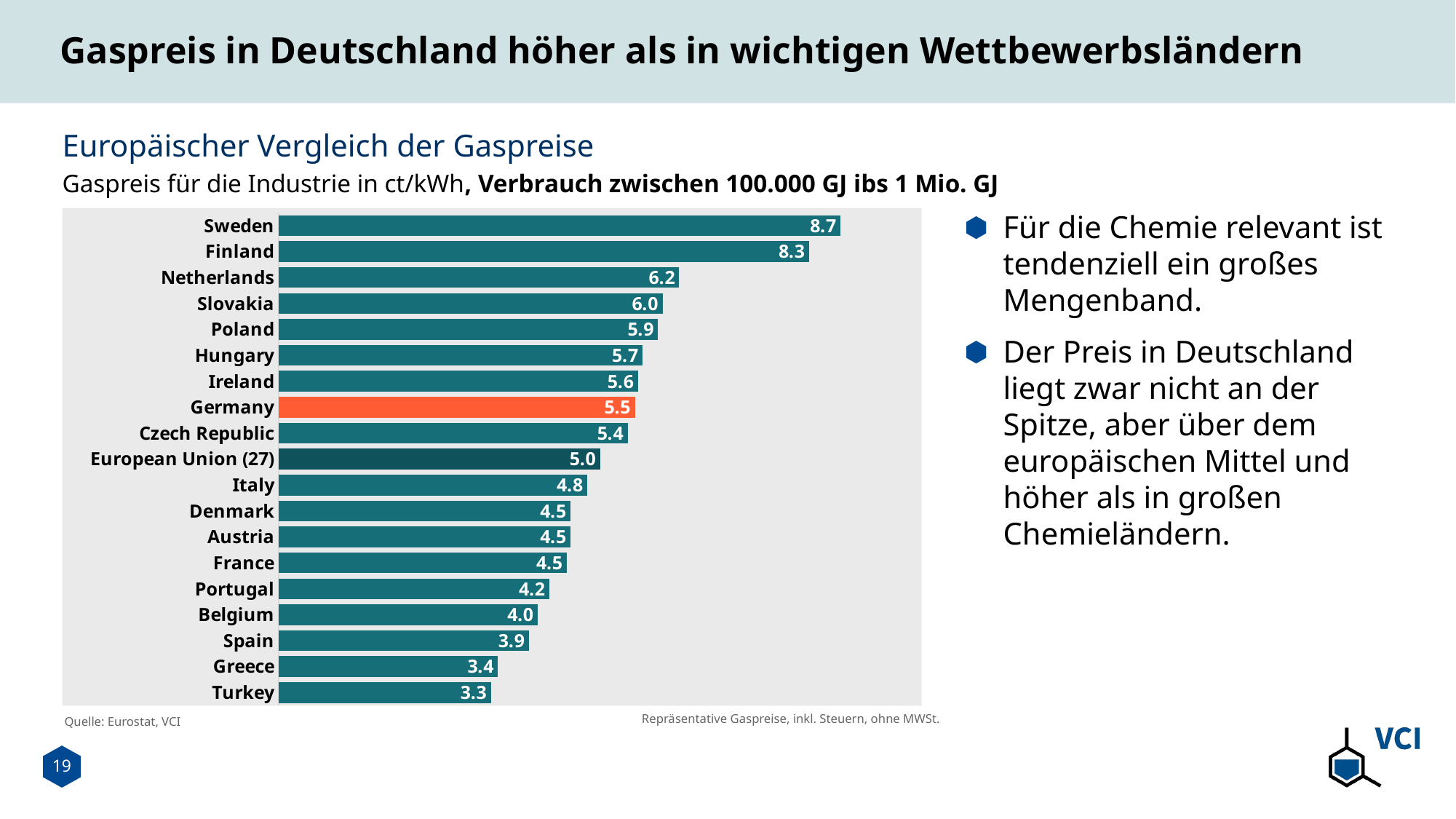
Which has a higher gas price, Poland or Italy? Poland Which country has the lowest gas price in the chart? Turkey What is the gas price for Netherlands? 6.2 Which has a higher gas price, Belgium or Spain? Belgium What is the difference between the gas price for Sweden and the gas price for Finland? 0.4 What is the gas price for the European Union (27)? 5.0 Which country has the highest gas price in the chart? Sweden What type of chart is shown on the slide? Bar chart What is the difference between the gas price for Germany and the gas price for the European Union (27)? 0.5 What is the gas price for Germany? 5.5 How many countries or regions are shown in the chart? 19 Which bar in the chart is highlighted in orange? Germany